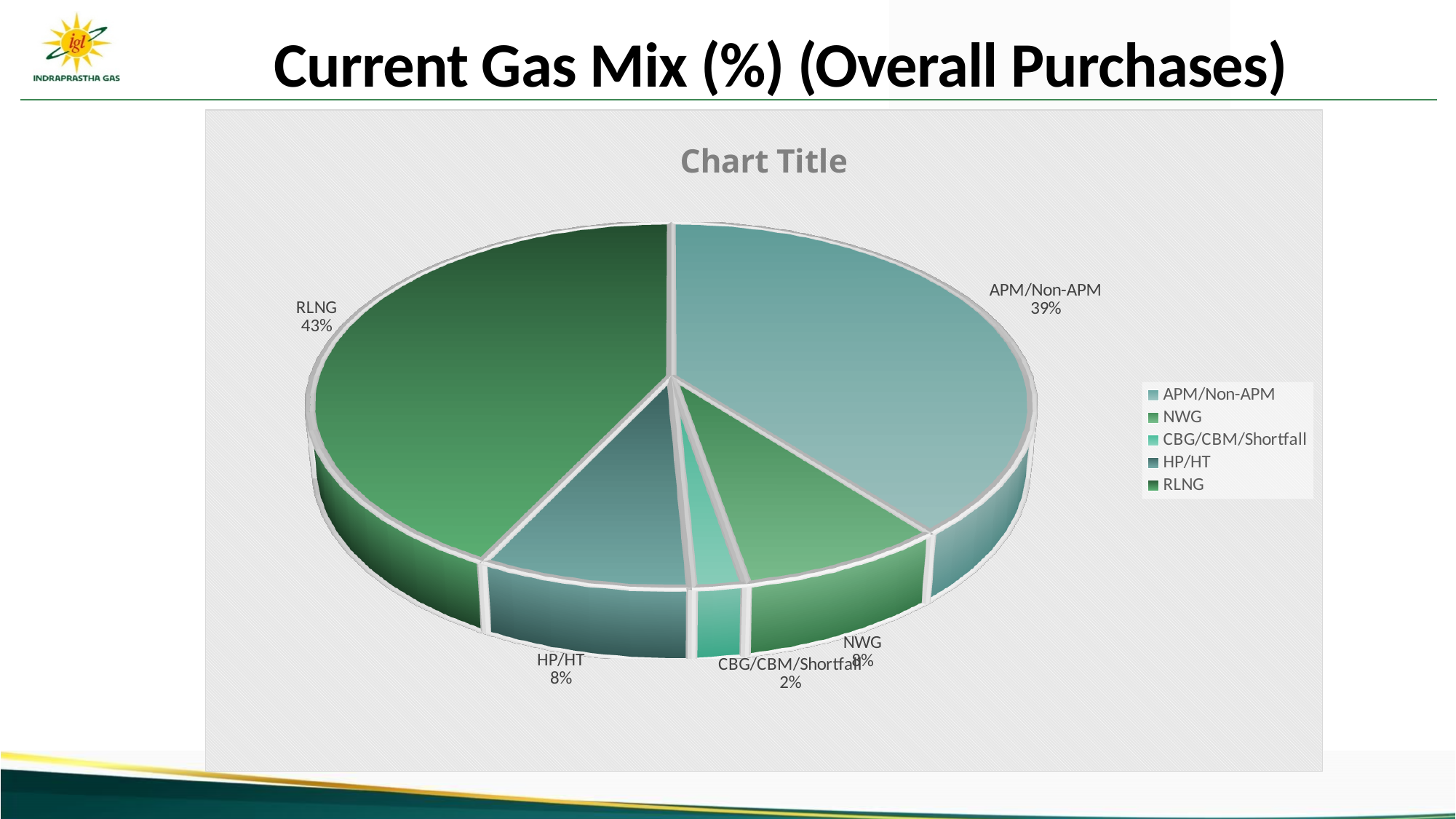
What title is printed above the pie chart inside the chart area? Chart Title Which category has the largest slice of the pie? RLNG Which category has the smallest slice of the pie? CBG/CBM/Shortfall What is the difference in percentage points between RLNG and APM/Non-APM? 4 What is the value shown for CBG/CBM/Shortfall? 2% What percentage of the pie does RLNG account for? 43% How many entries does the legend list? 5 What is the value shown for HP/HT? 8% How many slices does the pie chart have? 5 What is the value shown for APM/Non-APM? 39% What kind of chart is shown on the slide? Pie chart Which is larger, the slice for HP/HT or the slice for CBG/CBM/Shortfall? HP/HT